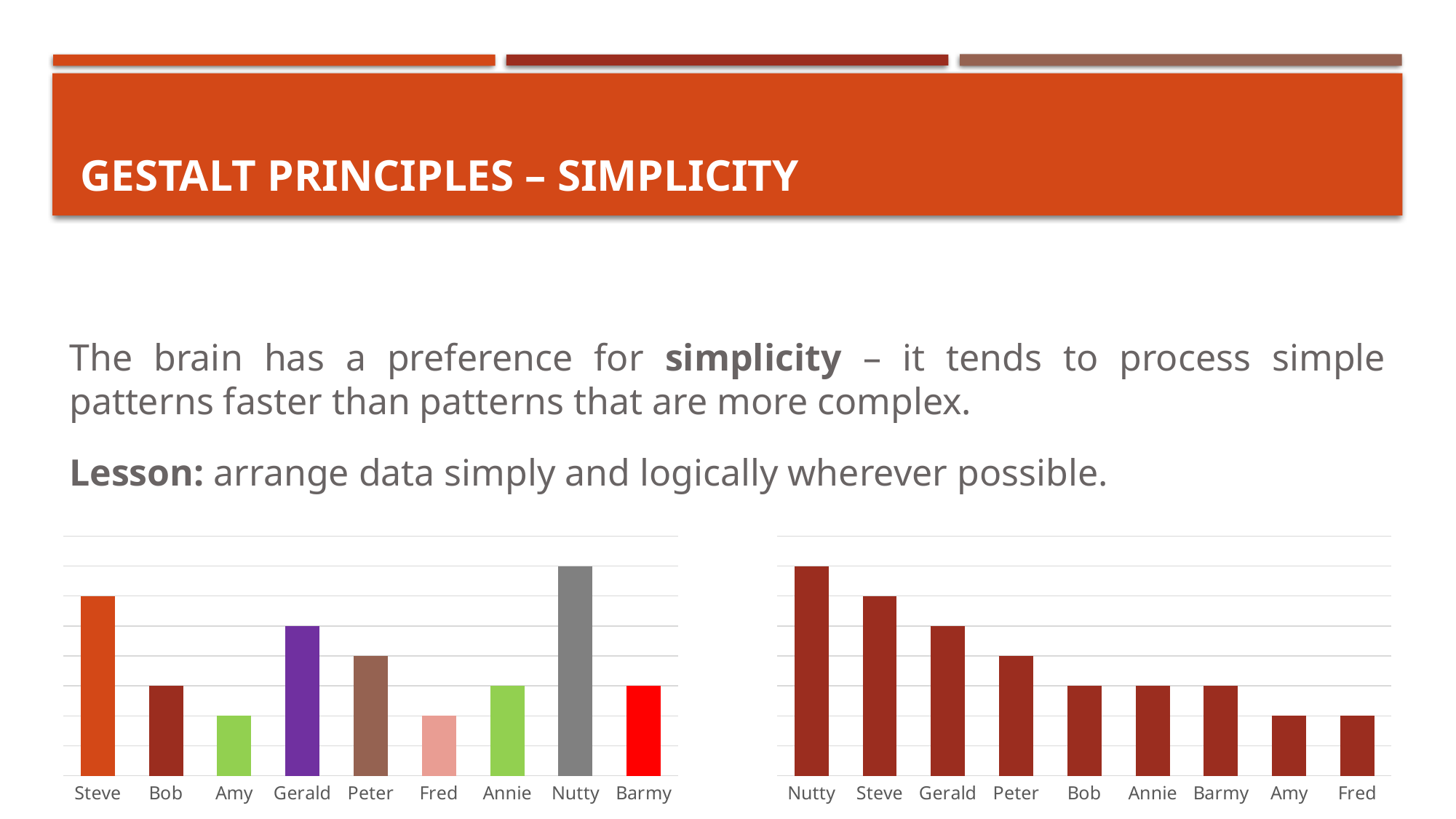
In the left chart, which is larger, the value for Gerald or the value for Peter? Gerald In the right chart, which category has the highest value? Nutty In the left chart, which category has the highest value? Nutty How many categories are shown in the right chart? 9 In the right chart, do the values rise or fall from left to right along the x axis? Fall In the right chart, which is larger, the value for Nutty or the value for Steve? Nutty In the right chart, which category is plotted first on the x axis? Nutty In the right chart, which is larger, the value for Peter or the value for Amy? Peter In the left chart, what colour is the bar for Nutty? Grey What kind of chart is the right chart? Bar chart How many categories are shown in the left chart? 9